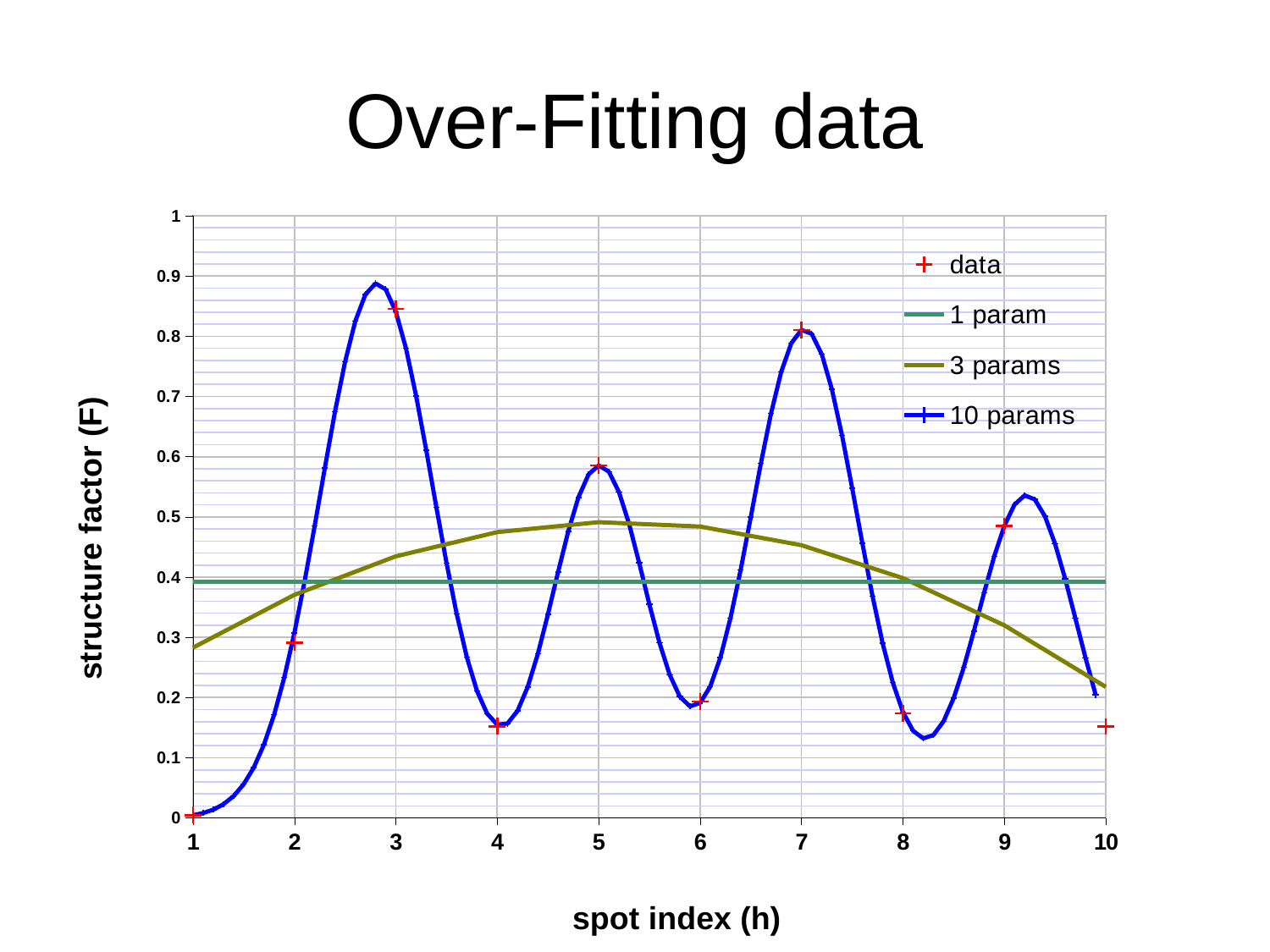
What kind of chart is shown on the slide? line chart Is the 'data' value at spot index 3 greater or less than 0.8? greater How many series does the chart legend list? 4 At which spot index is the 'data' value lowest? 1 Is the 'data' value at spot index 4 greater or less than 0.2? less What is the title of the chart on this slide? Over-Fitting data Is the 'data' value at spot index 5 greater or less than 0.5? greater Which has the larger 'data' value: spot index 3 or spot index 4? spot index 3 Does the '3 params' curve rise or fall between spot index 5 and spot index 10? fall What is the label of the y axis? structure factor (F) How many data points (red crosses) are plotted for the 'data' series? 10